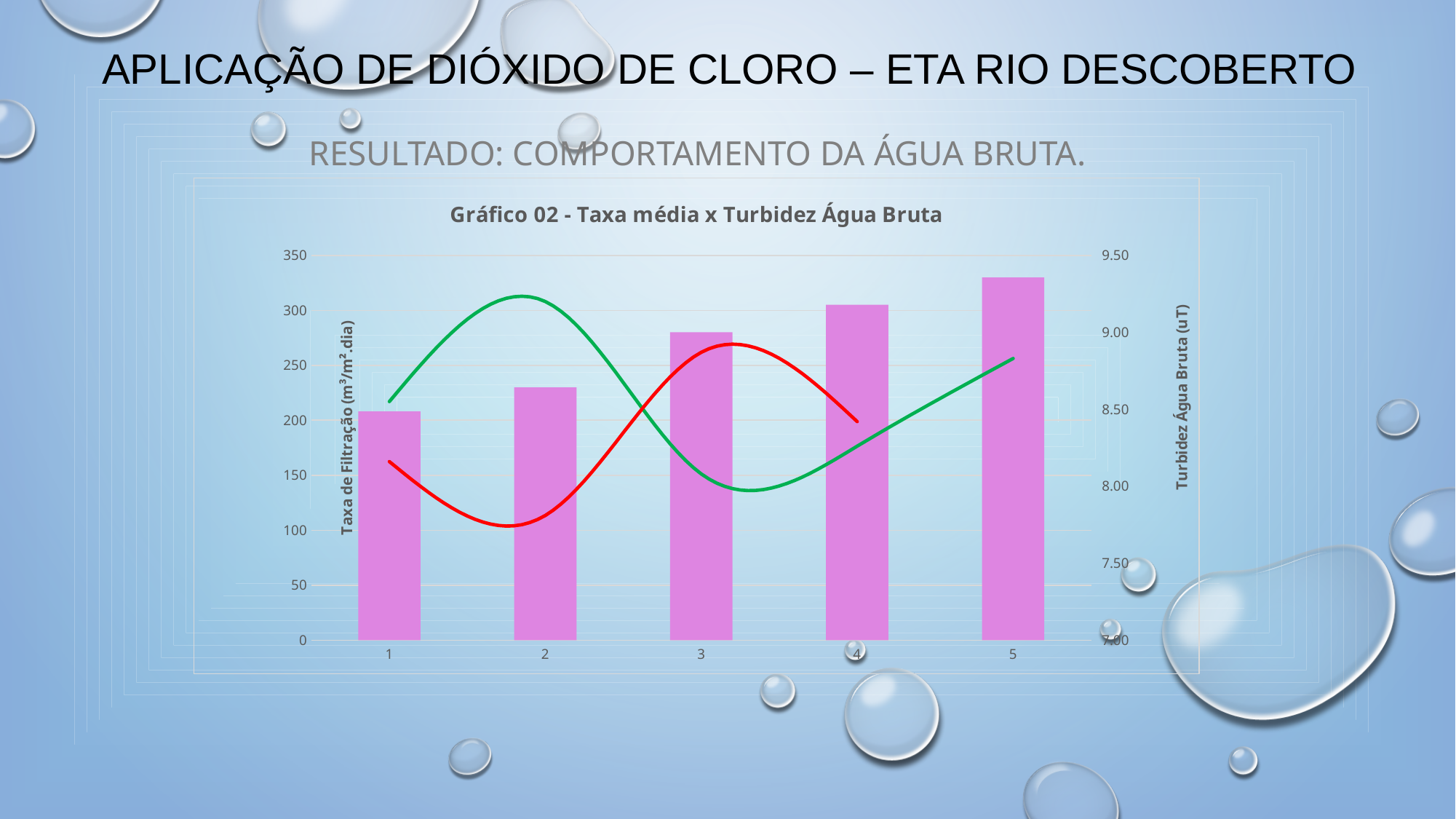
Which category has the shortest bar in the chart? 1 Is the bar value for category 1 greater or less than 250? less Is the bar value for category 3 greater or less than 250? greater Is the bar value for category 5 greater or less than 300? greater What is the title of the chart on the slide? Gráfico 02 - Taxa média x Turbidez Água Bruta How many categories are shown on the x axis of the chart? 5 What kind of chart is shown on the slide? bar and line chart Do the bar values rise or fall from category 1 to category 5? rise Which category has the tallest bar in the chart? 5 Which bar is taller, category 3 or category 2? 3 What is the label of the right-hand vertical axis of the chart? Turbidez Água Bruta (uT)